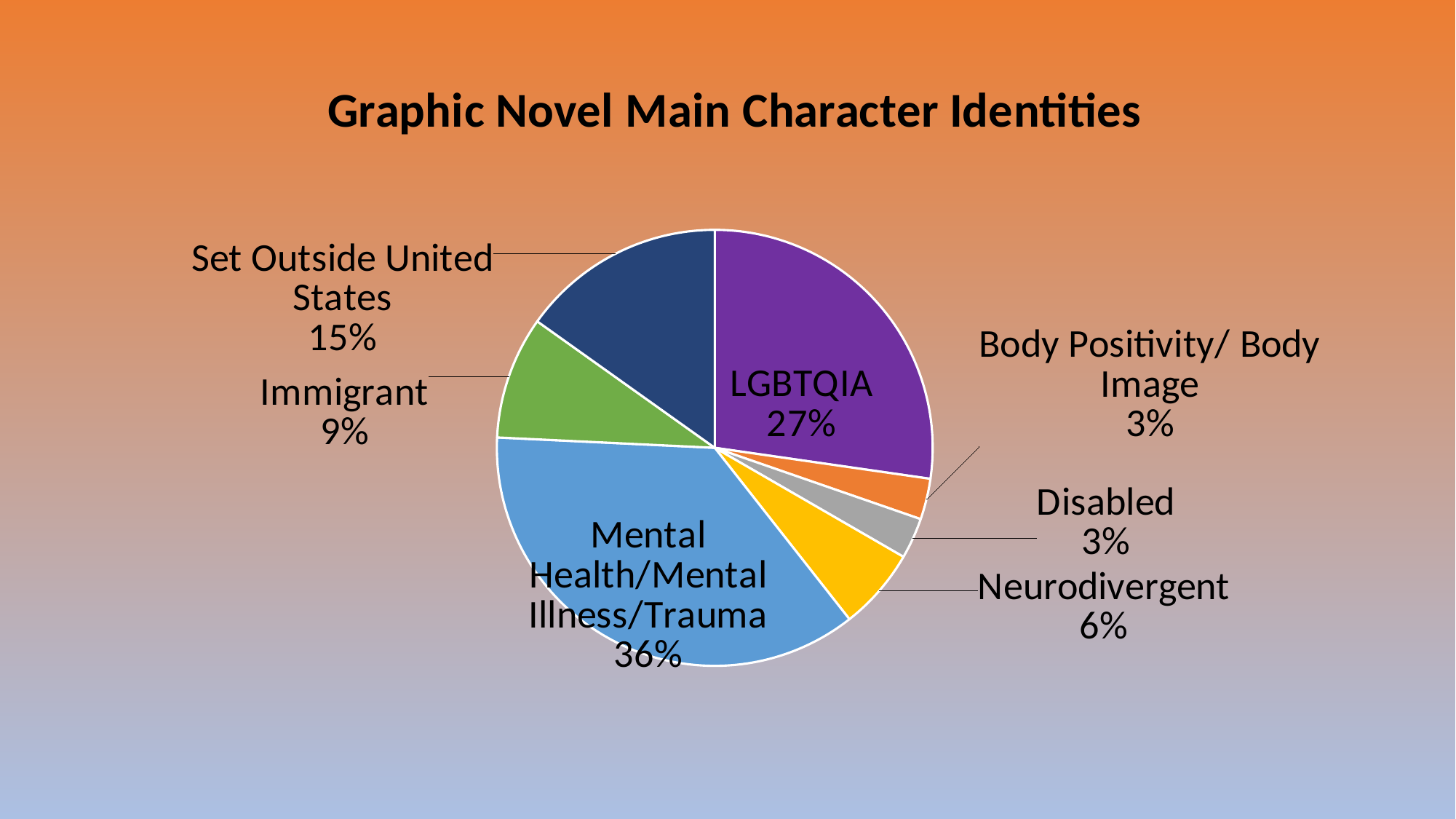
What is the difference in percentage points between Set Outside United States and Immigrant? 6 What percentage is shown for Neurodivergent? 6% What percentage is shown for Mental Health/Mental Illness/Trauma? 36% Which category has the largest slice of the pie? Mental Health/Mental Illness/Trauma What share of the pie does LGBTQIA represent? 27% Which is larger, the Immigrant slice or the Neurodivergent slice? Immigrant What is the difference in percentage points between Mental Health/Mental Illness/Trauma and LGBTQIA? 9 How many categories are shown in the pie chart? 7 What colour is the LGBTQIA slice? Purple What percentage is shown for Set Outside United States? 15% What kind of chart is shown on the slide? Pie chart What is the title of the chart? Graphic Novel Main Character Identities